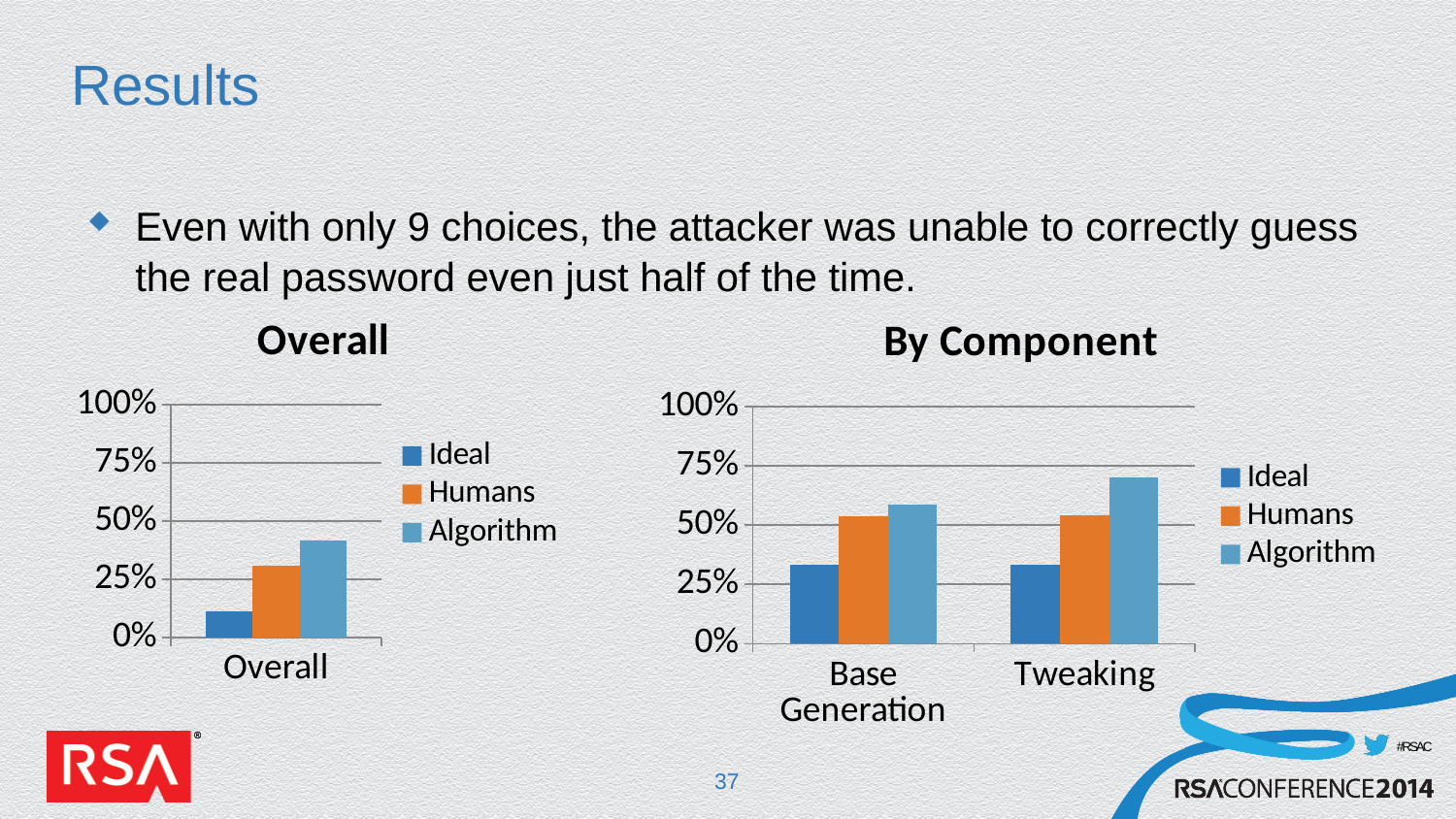
In the "By Component" chart, is the Algorithm value larger for Base Generation or for Tweaking? Tweaking In the "Overall" chart, is the value for Ideal greater or less than 25%? less How many series does the legend of the "By Component" chart list? 3 In the "Overall" chart, which series has the lowest bar? Ideal In the "Overall" chart, is the value for Algorithm greater or less than 50%? less How many categories are shown on the x axis of the "By Component" chart? 2 What are the three legend entries in the "Overall" chart? Ideal, Humans, Algorithm In the "Overall" chart, which series has the highest bar? Algorithm What kind of chart is the "Overall" chart? bar chart In the "By Component" chart, is the Ideal value for Base Generation greater or less than 50%? less In the "By Component" chart, which series has the lowest bar for Tweaking? Ideal